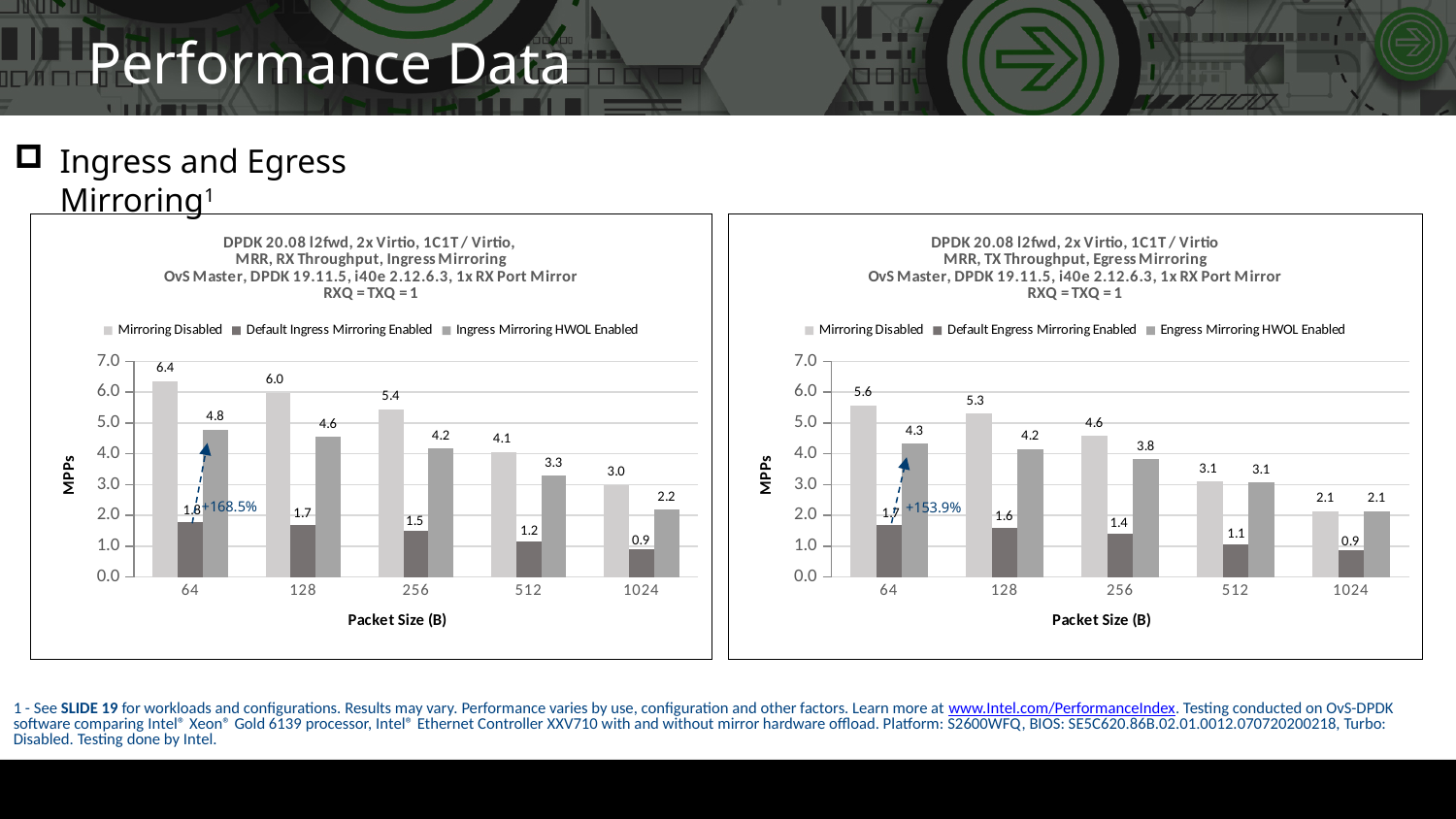
In the left chart (Ingress Mirroring), what is the difference between the Mirroring Disabled and Ingress Mirroring HWOL Enabled values at packet size 64? 1.6 In the right chart (Egress Mirroring), what is the Engress Mirroring HWOL Enabled value at packet size 256? 3.8 In the left chart (Ingress Mirroring), do the Mirroring Disabled values rise or fall as packet size increases? Fall In the right chart (Egress Mirroring), what is the difference between the Mirroring Disabled and Default Engress Mirroring Enabled values at packet size 128? 3.7 How many packet sizes are shown on the x axis of the right chart (Egress Mirroring)? 5 In the left chart (Ingress Mirroring), which is larger at packet size 512: the Mirroring Disabled value or the Ingress Mirroring HWOL Enabled value? Mirroring Disabled In the right chart (Egress Mirroring), which packet size has the highest Mirroring Disabled value? 64 How many series does the legend of the left chart (Ingress Mirroring) list? 3 What type of chart is the right chart (Egress Mirroring)? Bar chart In the left chart (Ingress Mirroring), what is the Mirroring Disabled value at packet size 64? 6.4 In the left chart (Ingress Mirroring), which packet size has the lowest Ingress Mirroring HWOL Enabled value? 1024 In the left chart (Ingress Mirroring), what is the Default Ingress Mirroring Enabled value at packet size 1024? 0.9